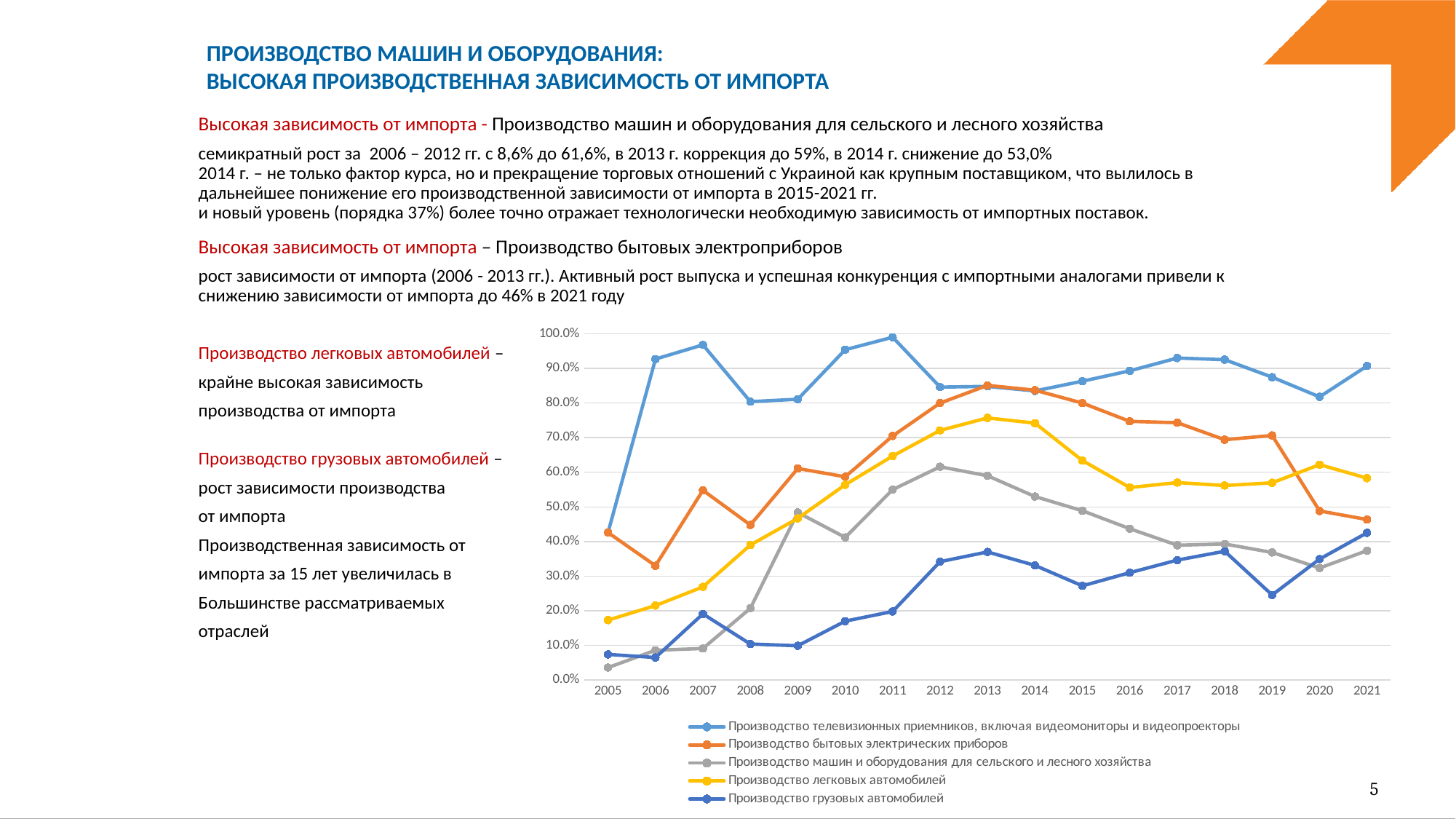
Is the value for Производство грузовых автомобилей in 2019 greater or less than 30.0%? less Does the value for Производство легковых автомобилей rise or fall from 2005 to 2013? rise What kind of chart is shown on the slide? Line chart Which series has the lowest value in 2019? Производство грузовых автомобилей How many years are plotted along the x axis of the chart? 17 Is the value for Производство машин и оборудования для сельского и лесного хозяйства in 2005 greater or less than 10.0%? less What colour is the line for Производство бытовых электрических приборов? Orange Is the value for Производство бытовых электрических приборов in 2013 greater or less than 80.0%? greater In 2021, which is larger: the value for Производство легковых автомобилей or the value for Производство бытовых электрических приборов? Производство легковых автомобилей How many series does the chart legend list? 5 Which series has the highest value in 2021? Производство телевизионных приемников, включая видеомониторы и видеопроекторы